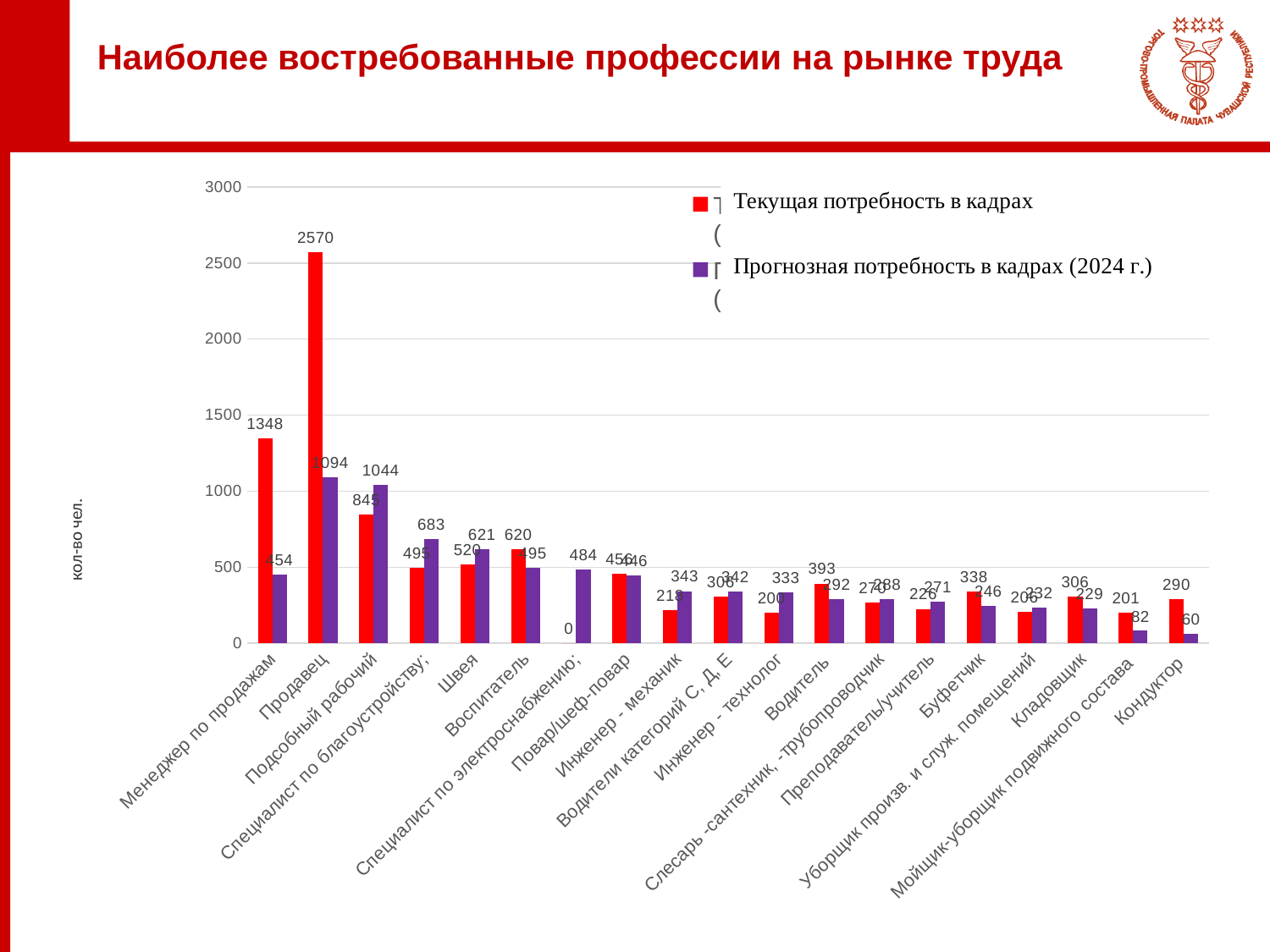
What is the difference between the current and forecast staffing need for Продавец? 1476 What is the current staffing need for Специалист по электроснабжению? 0 Which profession has the lowest forecast staffing need for 2024 (purple bars)? Кондуктор What is the forecast staffing need for 2024 (Прогнозная потребность в кадрах) for Менеджер по продажам? 454 Is the current staffing need for Повар/шеф-повар greater or less than 500? less What is the difference between the current and forecast staffing need for Менеджер по продажам? 894 How many series does the legend list? 2 What is the current staffing need (Текущая потребность в кадрах) for Продавец? 2570 Which profession has the highest current staffing need (red bars)? Продавец How many professions are shown on the x axis of the chart? 19 What kind of chart is shown on the slide? Bar chart For Подсобный рабочий, which is larger: the current need or the forecast need for 2024? Forecast need for 2024